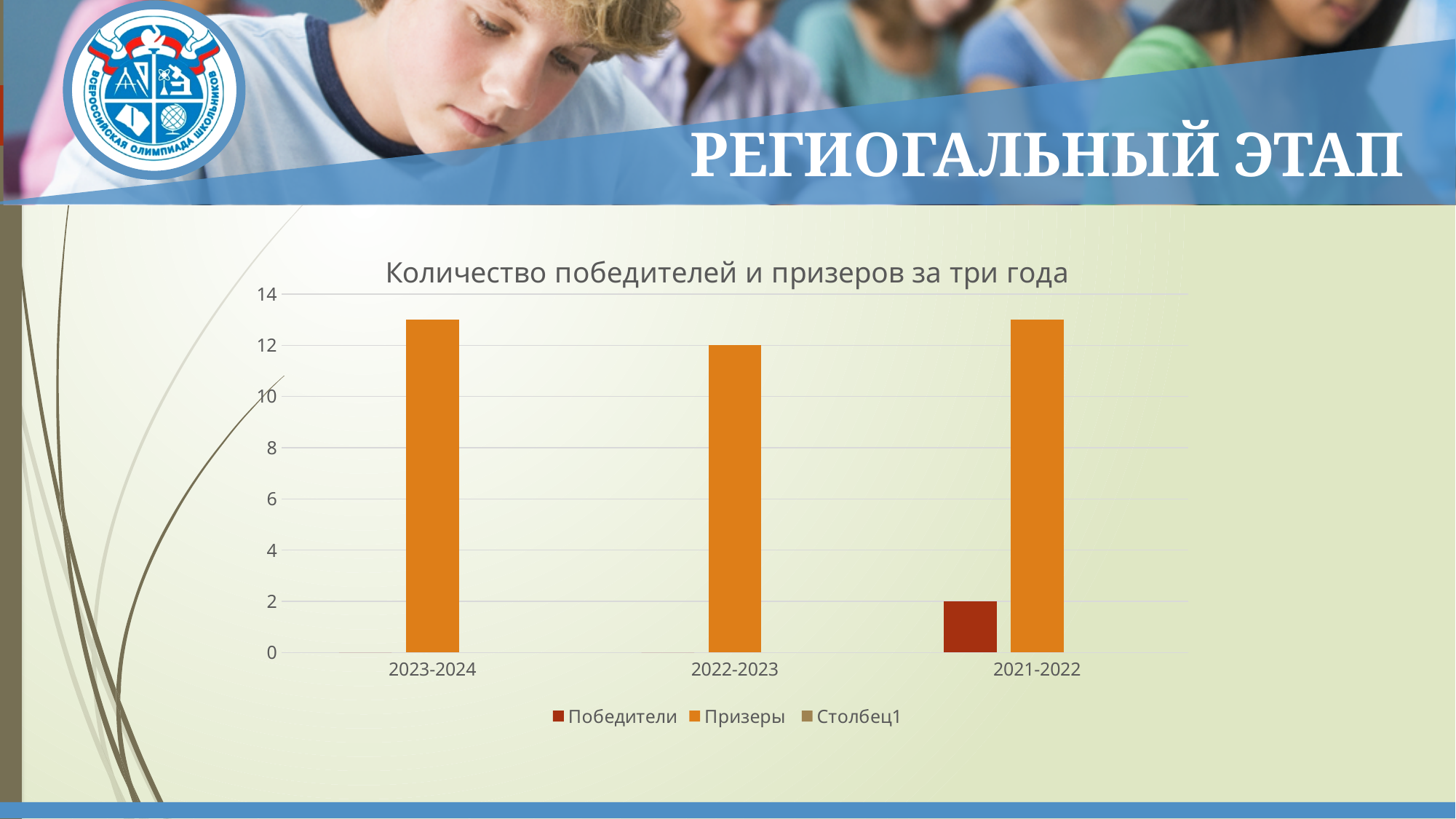
What is the difference between Призеры for 2022-2023 and Победители for 2021-2022? 10 What are the names of the series listed in the legend? Победители, Призеры, Столбец1 Is the value of Призеры for 2021-2022 greater or less than 12? greater Is the value of Призеры for 2023-2024 greater or less than 12? greater What is the title of the chart? Количество победителей и призеров за три года Which is larger: Призеры for 2022-2023 or Победители for 2021-2022? Призеры for 2022-2023 What is the value of Победители for 2021-2022? 2 What is the value of Призеры for 2022-2023? 12 How many year categories are shown on the x axis? 3 Which year has the lowest value for Призеры? 2022-2023 How many series does the legend list? 3 What kind of chart is shown on the slide? bar chart